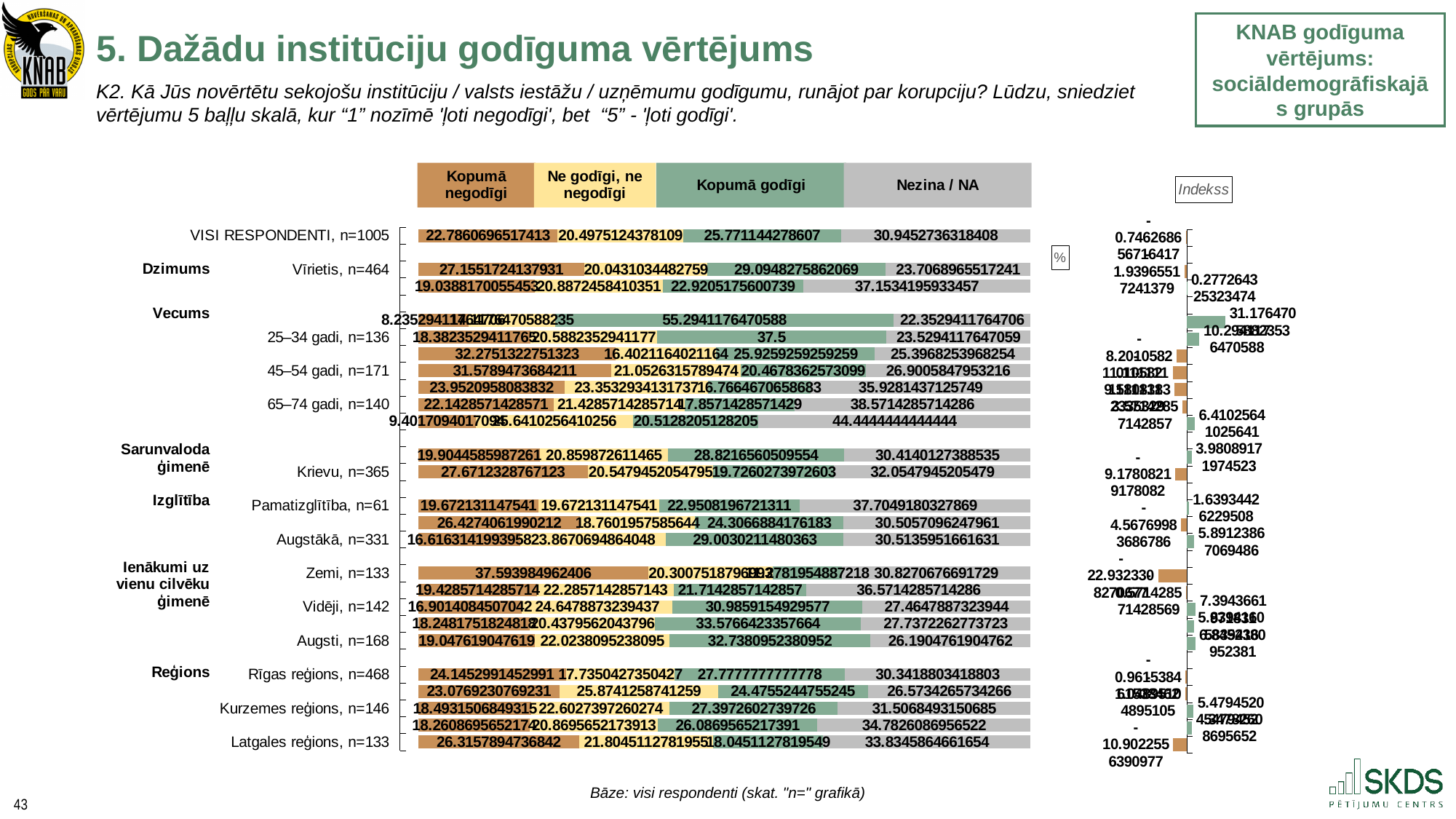
What is the 'Kopumā negodīgi' value for 'Zemi, n=133'? 37.593984962406 What is the 'Kopumā negodīgi' value for '45–54 gadi, n=171'? 31.5789473684211 What is the 'Kopumā godīgi' value for 'Augsti, n=168'? 32.7380952380952 What is the 'Nezina / NA' value for '65–74 gadi, n=140'? 38.5714285714286 What is the 'Kopumā godīgi' value for '25–34 gadi, n=136'? 37.5 How many series does the legend of the chart list? 4 For 'Augsti, n=168', which is larger: 'Kopumā godīgi' or 'Kopumā negodīgi'? Kopumā godīgi For 'VISI RESPONDENTI, n=1005', which segment has the largest value? Nezina / NA What kind of chart is shown on the slide? bar chart For 'Latgales reģions, n=133', which is larger: 'Kopumā negodīgi' or 'Kopumā godīgi'? Kopumā negodīgi What is the 'Kopumā negodīgi' value for 'Vīrietis, n=464'? 27.1551724137931 What is the 'Nezina / NA' value for 'VISI RESPONDENTI, n=1005'? 30.9452736318408